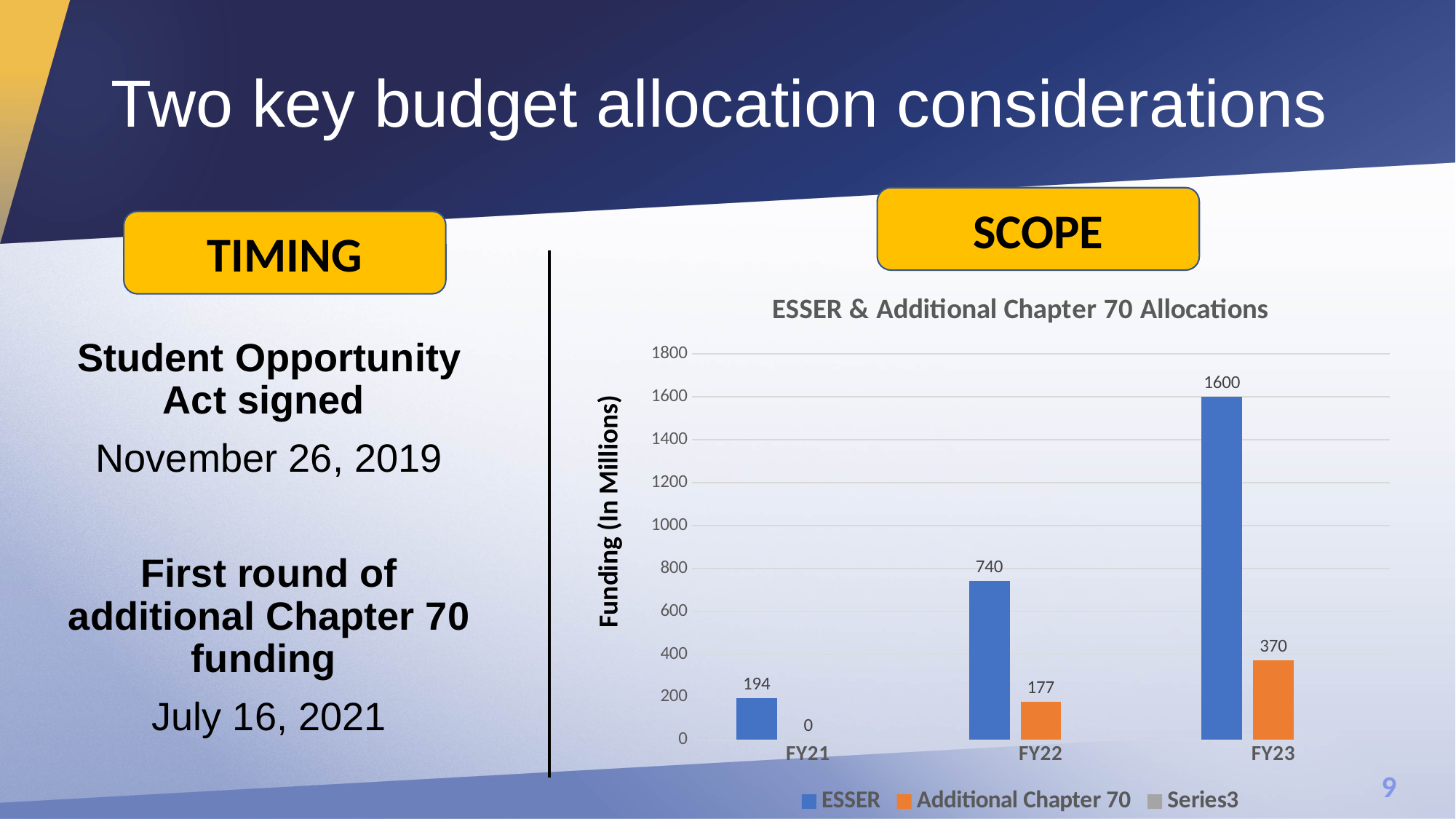
What kind of chart is shown on the slide? Bar chart Which fiscal year has the highest ESSER allocation? FY23 What is the difference between the ESSER and Additional Chapter 70 values for FY23? 1230 What is the title of the chart? ESSER & Additional Chapter 70 Allocations What is the Additional Chapter 70 value for FY23? 370 How many series does the legend list? 3 Which is larger in FY22, ESSER or Additional Chapter 70? ESSER Do the ESSER values rise or fall from FY21 to FY23? Rise Which fiscal year has the lowest ESSER allocation? FY21 What is the Additional Chapter 70 value for FY21? 0 How many fiscal years are shown on the x axis? 3 What is the ESSER value for FY22? 740